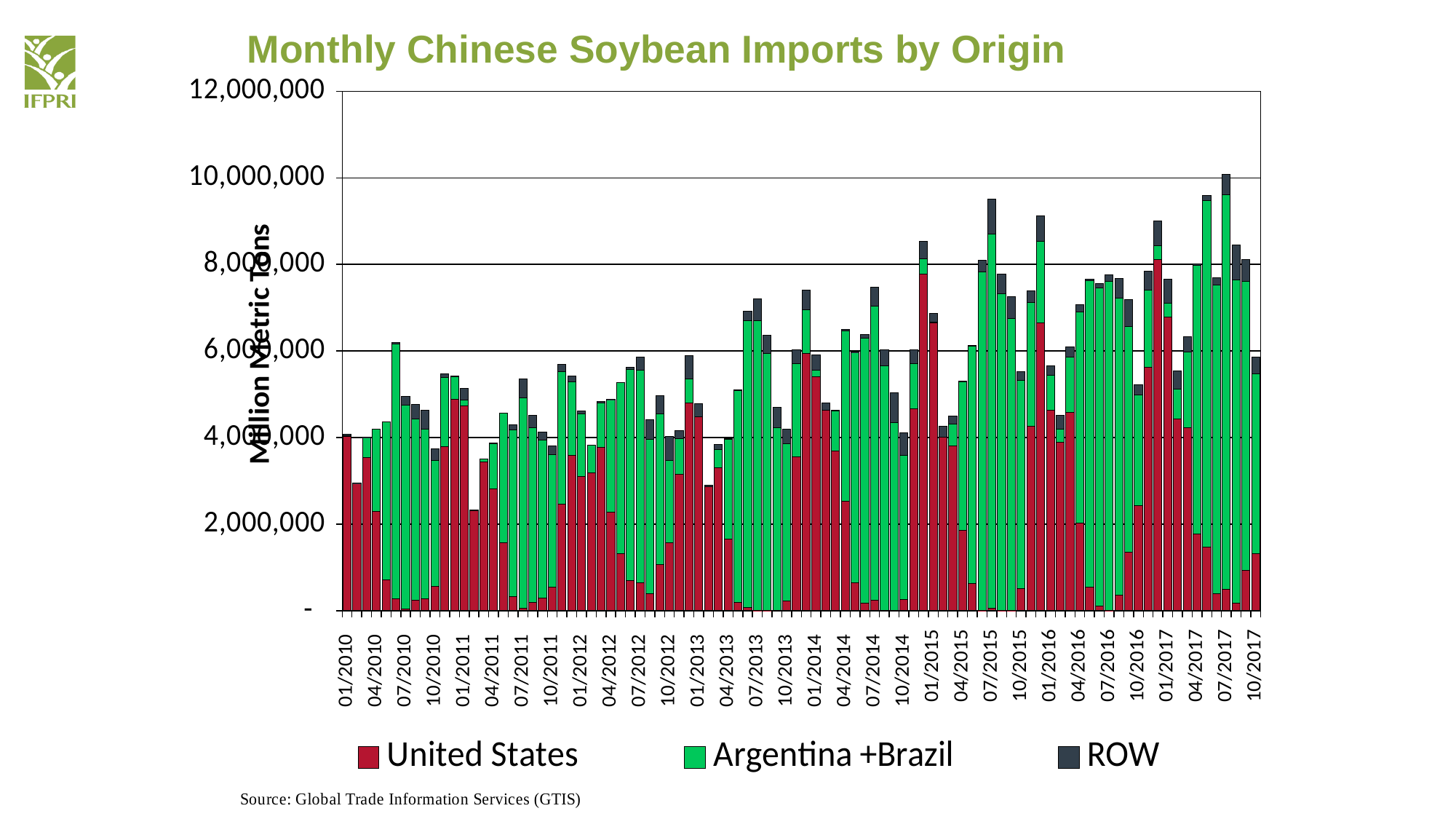
Is the total import value for 10/2017 greater or less than 4,000,000? greater Is the total import value for 01/2013 greater or less than 4,000,000? greater Do total monthly imports generally rise or fall from 2010 to 2017? rise How many series does the legend list? 3 Which series is shown in red in the legend? United States What kind of chart is shown on the slide? Stacked bar chart Is the total import value for 01/2015 greater or less than 8,000,000? less Which month has the larger total imports, 01/2015 or 01/2013? 01/2015 What is the title of the chart? Monthly Chinese Soybean Imports by Origin